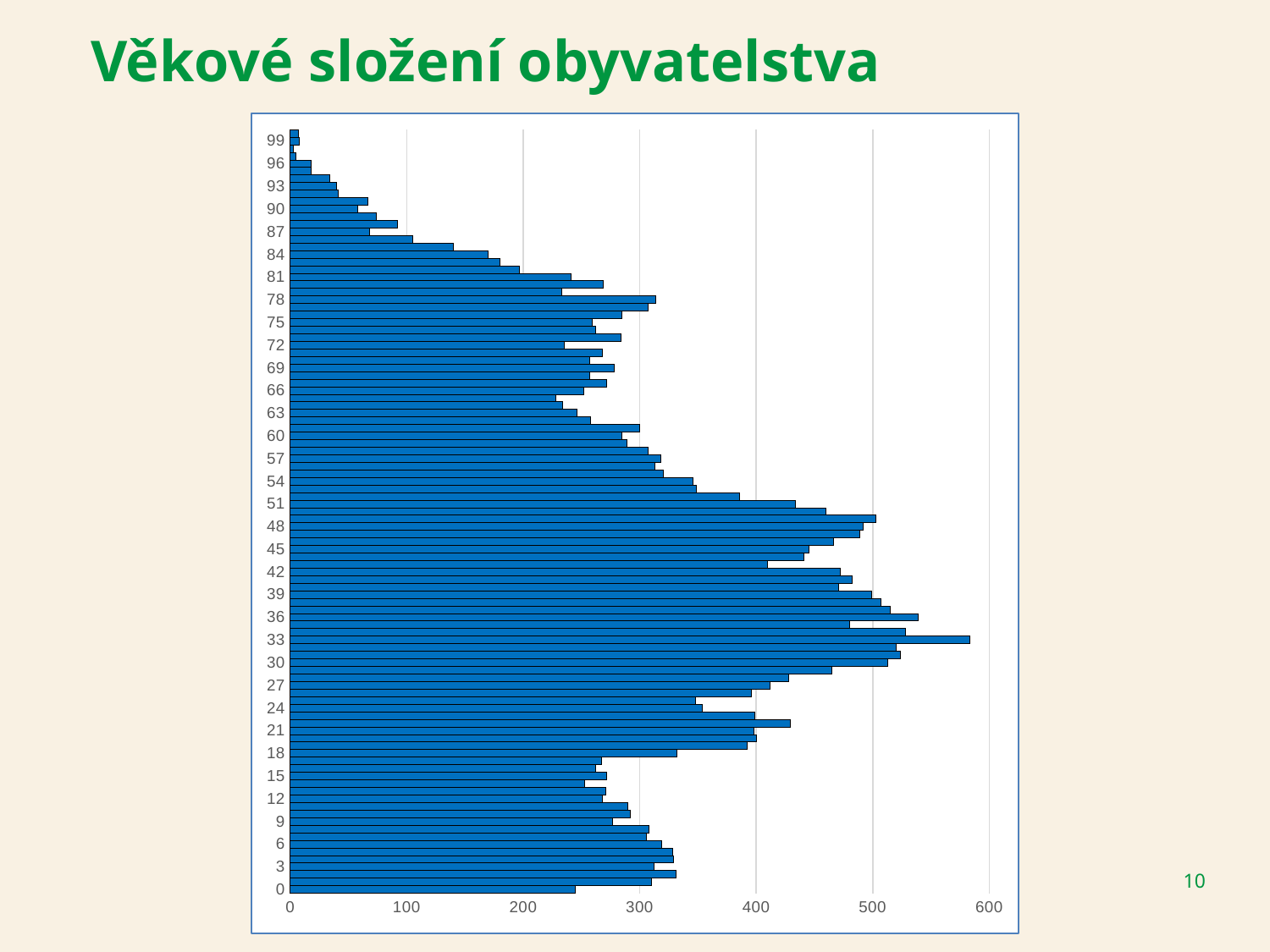
Is the value for age 84 greater or less than 200? less What is the title of the chart? Věkové složení obyvatelstva Is the value for age 90 greater or less than 100? less Is the value for age 0 greater or less than 300? less What type of chart is shown on the slide? bar chart Which has the larger value, age 48 or age 84? 48 Which age has the longest bar in the chart? 33 Do the bar lengths generally rise or fall as age increases from 60 to 99? fall Which has the larger value, age 21 or age 12? 21